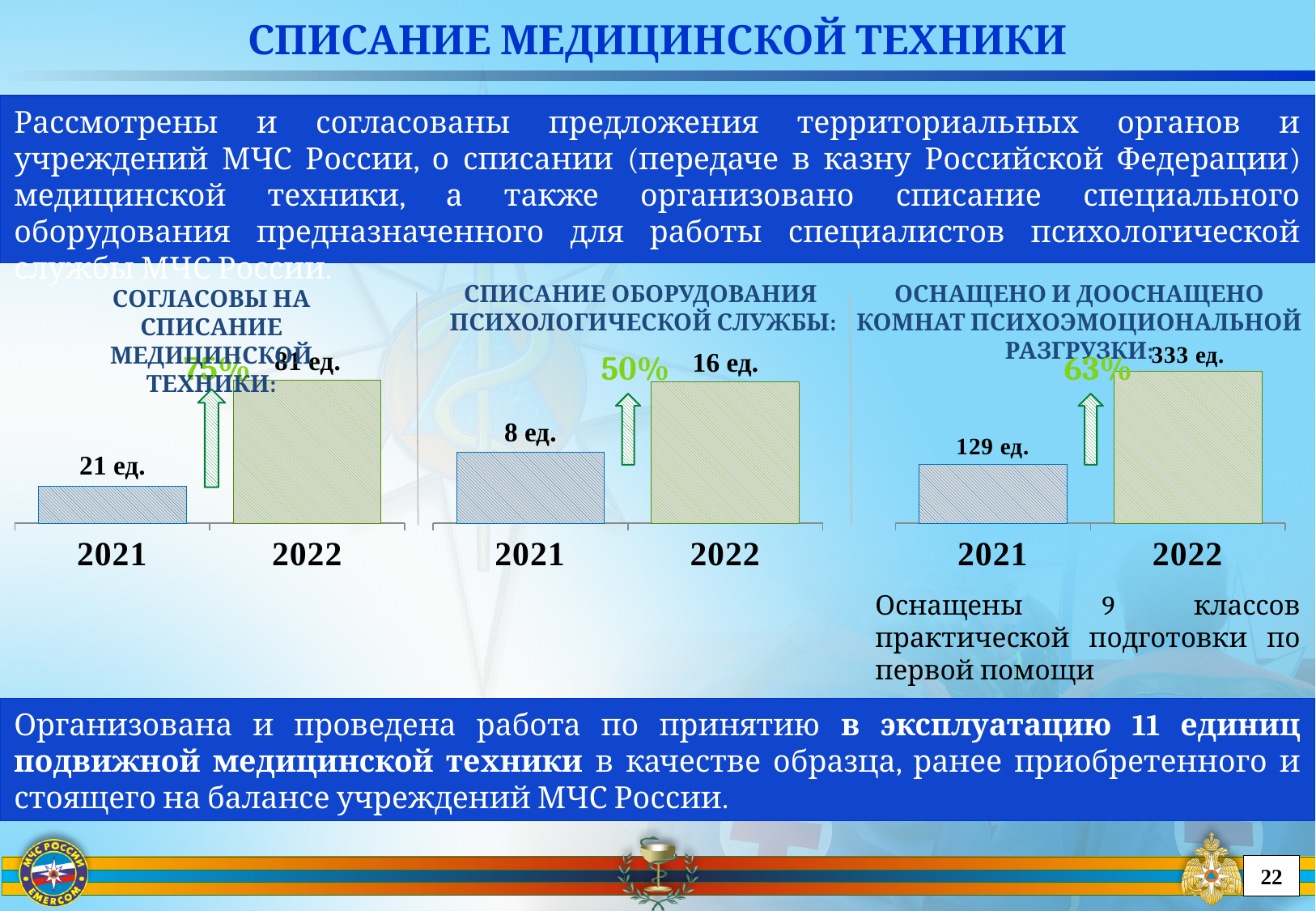
In the middle chart (СПИСАНИЕ ОБОРУДОВАНИЯ ПСИХОЛОГИЧЕСКОЙ СЛУЖБЫ), what is the value for 2022? 16 ед. In the left chart (СОГЛАСОВЫ НА СПИСАНИЕ МЕДИЦИНСКОЙ ТЕХНИКИ), what is the value for 2022? 81 ед. In the middle chart, which year has the higher value? 2022 What type of chart is the middle chart (СПИСАНИЕ ОБОРУДОВАНИЯ ПСИХОЛОГИЧЕСКОЙ СЛУЖБЫ)? Bar chart In the middle chart (СПИСАНИЕ ОБОРУДОВАНИЯ ПСИХОЛОГИЧЕСКОЙ СЛУЖБЫ), what is the value for 2021? 8 ед. In the left chart (СОГЛАСОВЫ НА СПИСАНИЕ МЕДИЦИНСКОЙ ТЕХНИКИ), what is the value for 2021? 21 ед. In the right chart, which year has the lower value? 2021 In the right chart (ОСНАЩЕНО И ДООСНАЩЕНО КОМНАТ ПСИХОЭМОЦИОНАЛЬНОЙ РАЗГРУЗКИ), what is the value for 2022? 333 ед. What percentage increase is shown above the arrow in the right chart (ОСНАЩЕНО И ДООСНАЩЕНО КОМНАТ ПСИХОЭМОЦИОНАЛЬНОЙ РАЗГРУЗКИ)? 63% In the right chart, what is the difference between the 2022 and 2021 values? 204 ед. In the right chart (ОСНАЩЕНО И ДООСНАЩЕНО КОМНАТ ПСИХОЭМОЦИОНАЛЬНОЙ РАЗГРУЗКИ), what is the value for 2021? 129 ед. In the left chart, what is the difference between the 2022 and 2021 values? 60 ед.